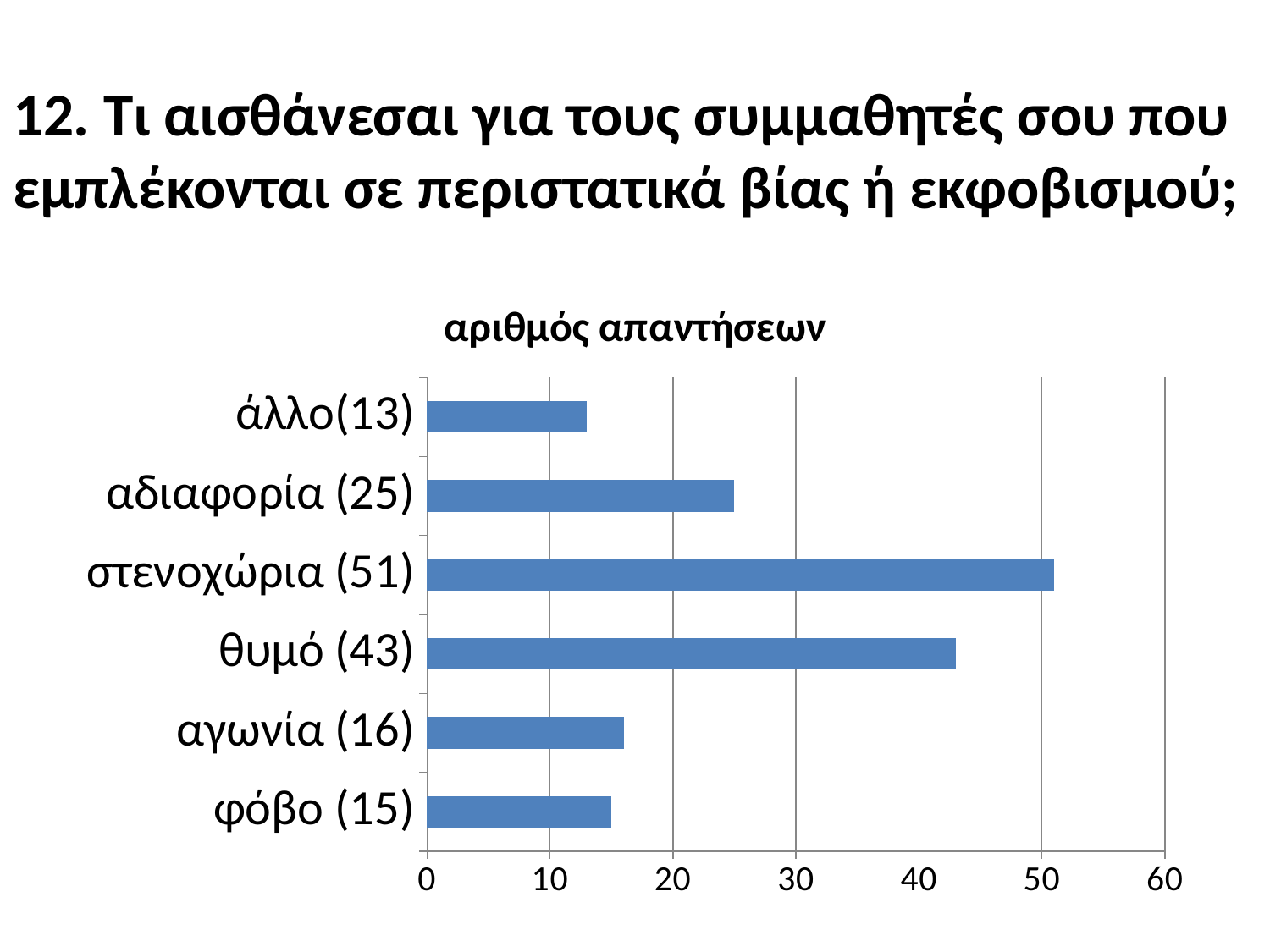
What is the number of responses for στενοχώρια? 51 Which has more responses, αγωνία or φόβο? αγωνία What is the number of responses for θυμό? 43 What is the title of the chart? αριθμός απαντήσεων Which category has the lowest number of responses? άλλο Which category has the highest number of responses? στενοχώρια What is the difference between the responses for στενοχώρια and θυμό? 8 Is the value for αδιαφορία greater or less than 20? greater What is the difference between the responses for αδιαφορία and άλλο? 12 What kind of chart is shown on the slide? bar chart How many categories does the chart show? 6 What is the number of responses for αδιαφορία? 25